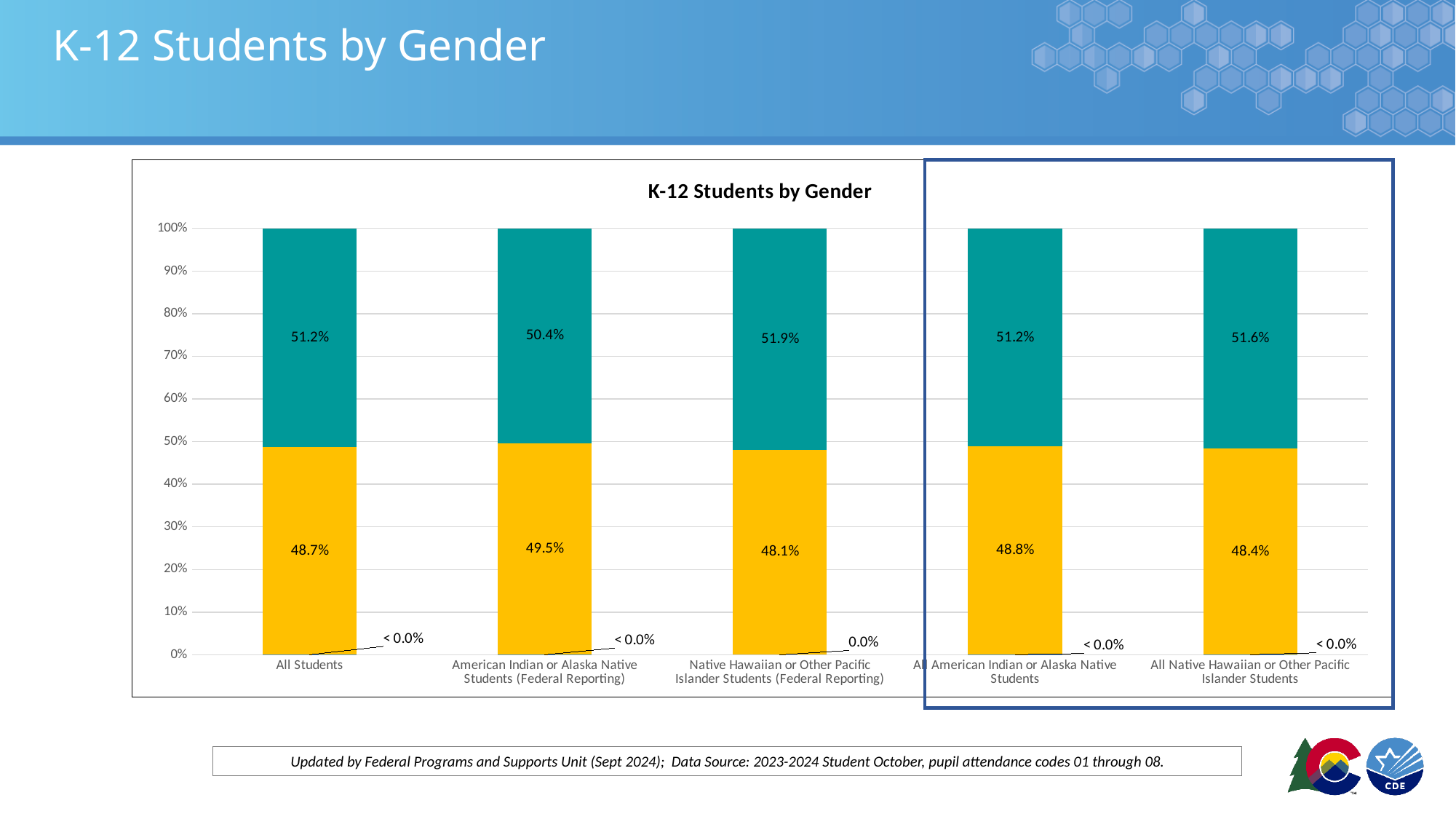
What label is shown for the smallest segment of the Native Hawaiian or Other Pacific Islander Students (Federal Reporting) bar? 0.0% Which category has the lowest value for the yellow (bottom) segment? Native Hawaiian or Other Pacific Islander Students (Federal Reporting) What is the value of the teal (top) segment for All Native Hawaiian or Other Pacific Islander Students? 51.6% What is the value of the yellow (bottom) segment for Native Hawaiian or Other Pacific Islander Students (Federal Reporting)? 48.1% Which is larger for All American Indian or Alaska Native Students: the teal (top) segment or the yellow (bottom) segment? The teal (top) segment How many categories are shown on the x axis? 5 Which category has the highest value for the teal (top) segment? Native Hawaiian or Other Pacific Islander Students (Federal Reporting) What kind of chart is shown on the slide? Stacked bar chart What is the title of the chart? K-12 Students by Gender What is the value of the yellow (bottom) segment for American Indian or Alaska Native Students (Federal Reporting)? 49.5% What is the difference between the teal (top) and yellow (bottom) segment values for All Students? 2.5 percentage points What is the value of the teal (top) segment for All Students? 51.2%